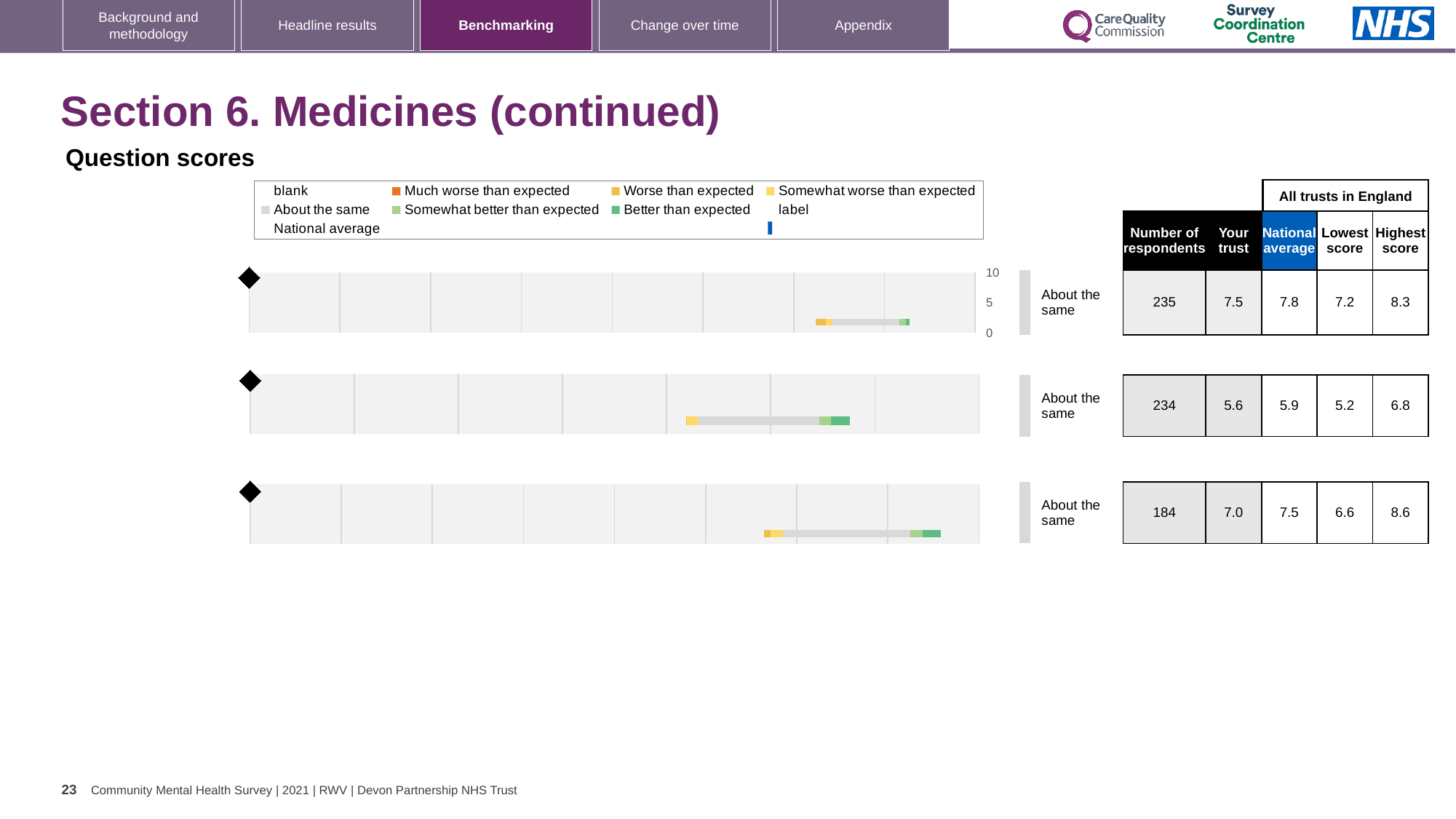
For the middle chart, what is the 'Your trust' score? 5.6 For the top chart, what is the national average score? 7.8 Which chart (top, middle or bottom) has the highest 'Your trust' score? Top For the bottom chart, what is the difference between the highest score and the lowest score? 2.0 For the bottom chart, how many respondents are there? 184 What kind of chart is used to show the question scores on this slide? bar chart For the middle chart, what is the highest score among all trusts in England? 6.8 For the middle chart, what benchmark category is the trust's result given as? About the same How many benchmarking charts are shown on the slide? 3 For the bottom chart, what is the lowest score among all trusts in England? 6.6 For the top chart, what is the 'Your trust' score? 7.5 For the top chart, which is larger: the 'Your trust' score or the national average? National average